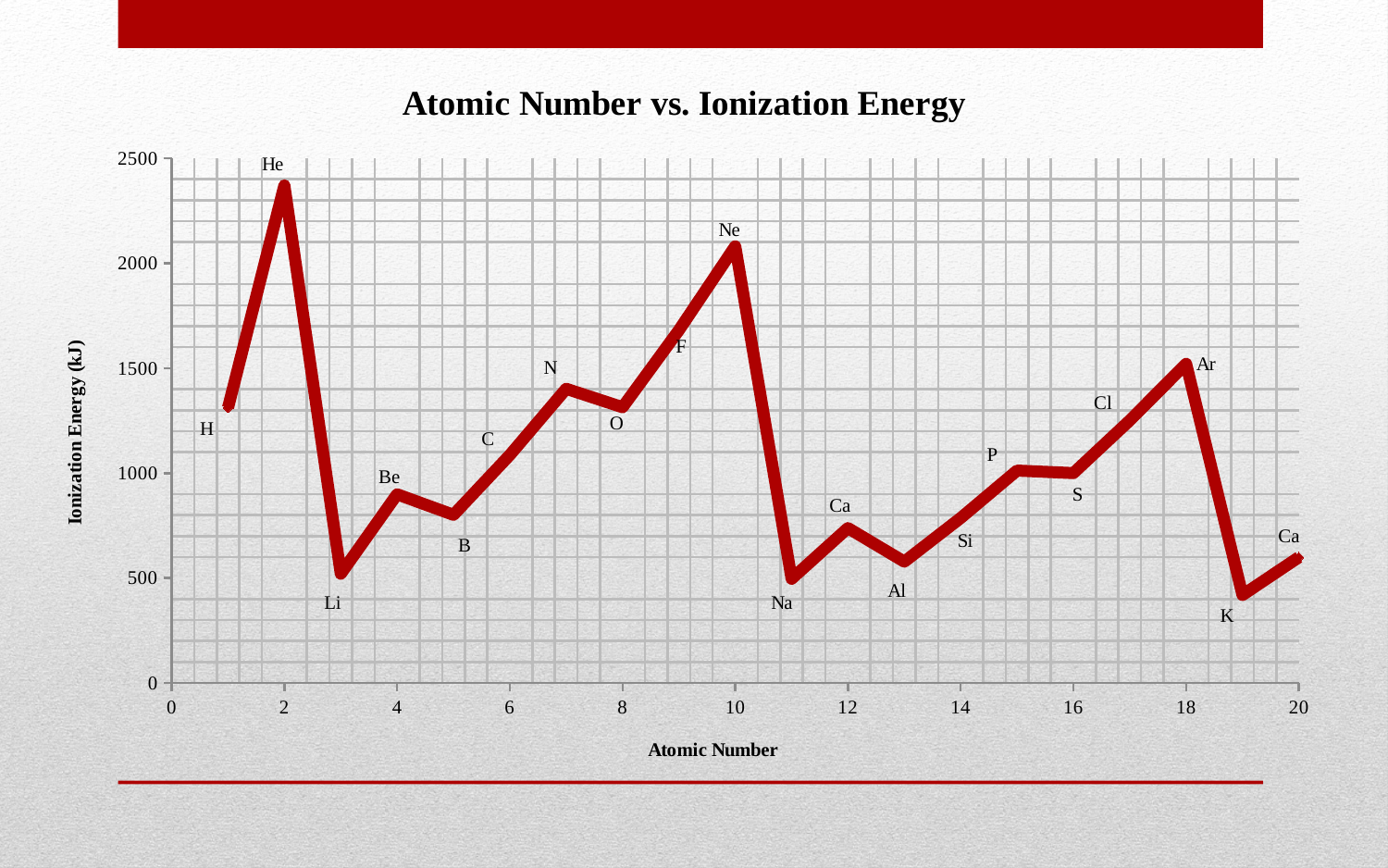
Is the ionization energy for He greater or less than 2000? greater Which has the higher ionization energy, Li or Be? Be Which has the higher ionization energy, Al or Si? Si Is the ionization energy for Li greater or less than 1000? less What kind of chart is shown on the slide? line chart Which element has the highest ionization energy on the chart? He Is the ionization energy for K greater or less than 500? less What is the title of the y axis? Ionization Energy (kJ) How many data points are plotted on the chart? 20 Which has the higher ionization energy, He or Ne? He Which element has the lowest ionization energy on the chart? K